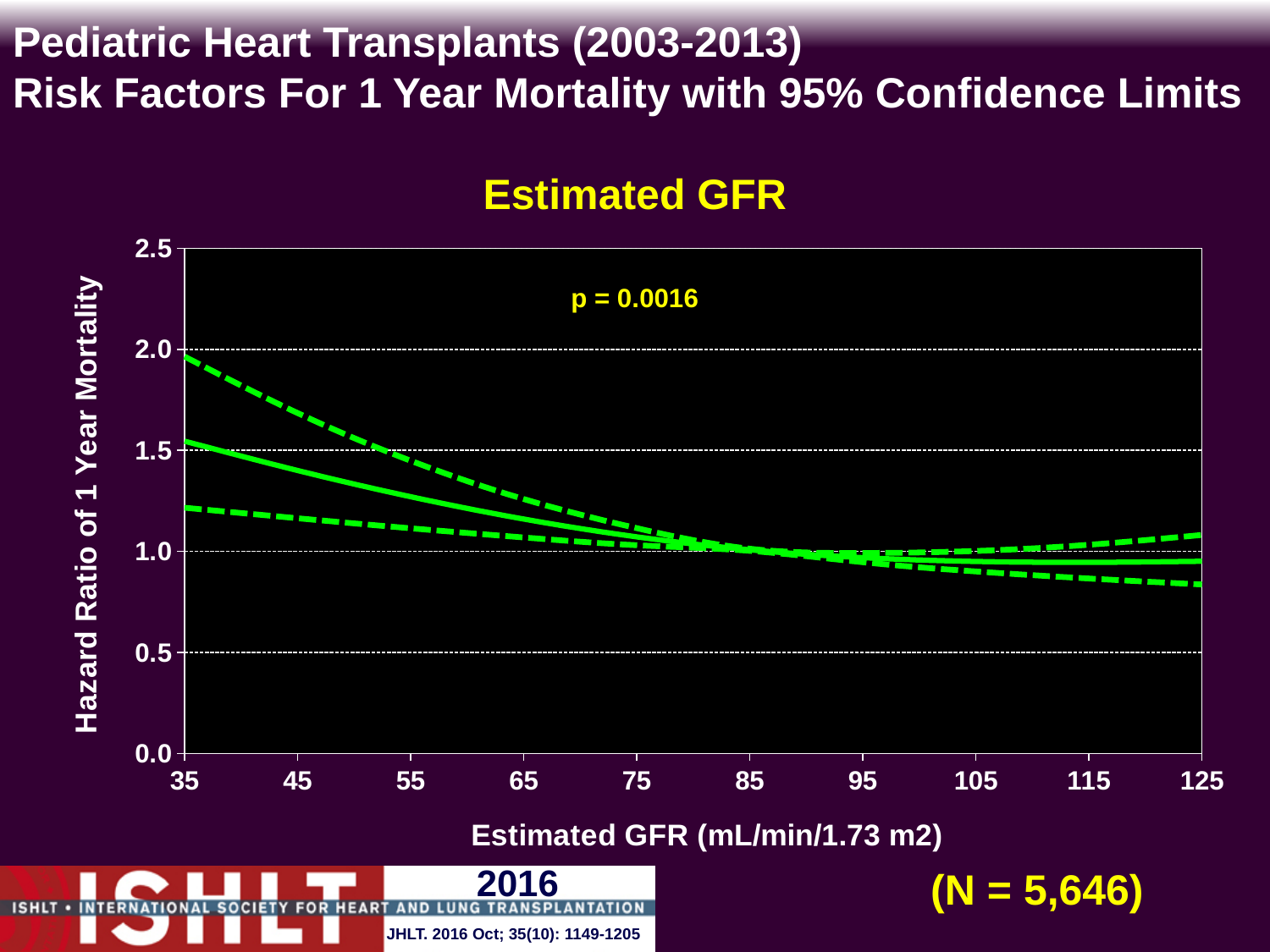
Is the lower confidence limit (lower dashed line) at an estimated GFR of 125 greater or less than 1.0? less What is the p-value printed on the chart? p = 0.0016 Does the hazard ratio of 1 year mortality rise or fall as estimated GFR increases from 35 to 125? fall How many tick labels are shown on the x axis? 10 Is the hazard ratio (solid line) at an estimated GFR of 65 greater or less than 1.0? greater How many lines are plotted on the chart? 3 What kind of chart is shown on the slide? line chart Is the upper confidence limit (upper dashed line) at an estimated GFR of 35 greater or less than 1.5? greater What is the sample size (N) shown on the slide? N = 5,646